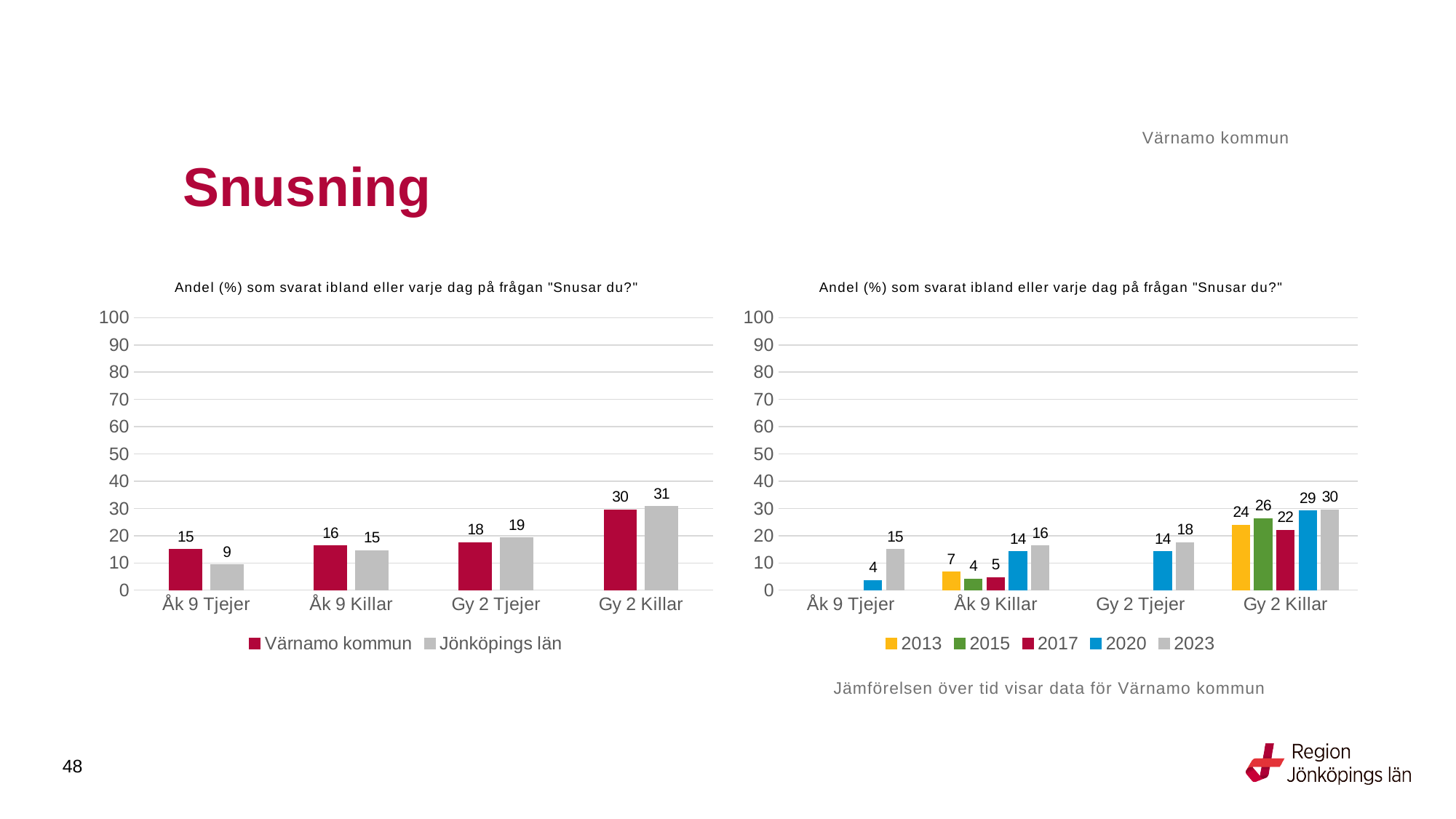
In the right chart, which year has the lowest value for Åk 9 Killar? 2015 In the left chart, what is the difference between Värnamo kommun and Jönköpings län for Åk 9 Tjejer? 6 In the right chart, how many series does the legend list? 5 What kind of chart is the left chart? Bar chart In the left chart, which category has the highest value for Jönköpings län? Gy 2 Killar In the right chart, what is the value for 2013 for Gy 2 Killar? 24 In the left chart, what is the value for Värnamo kommun for Gy 2 Killar? 30 In the left chart, how many series does the legend list? 2 In the right chart, what is the difference between 2023 and 2020 for Gy 2 Tjejer? 4 In the left chart, what is the value for Jönköpings län for Åk 9 Tjejer? 9 In the right chart, what is the value for 2020 for Åk 9 Tjejer? 4 In the left chart, which is larger for Gy 2 Tjejer: Värnamo kommun or Jönköpings län? Jönköpings län